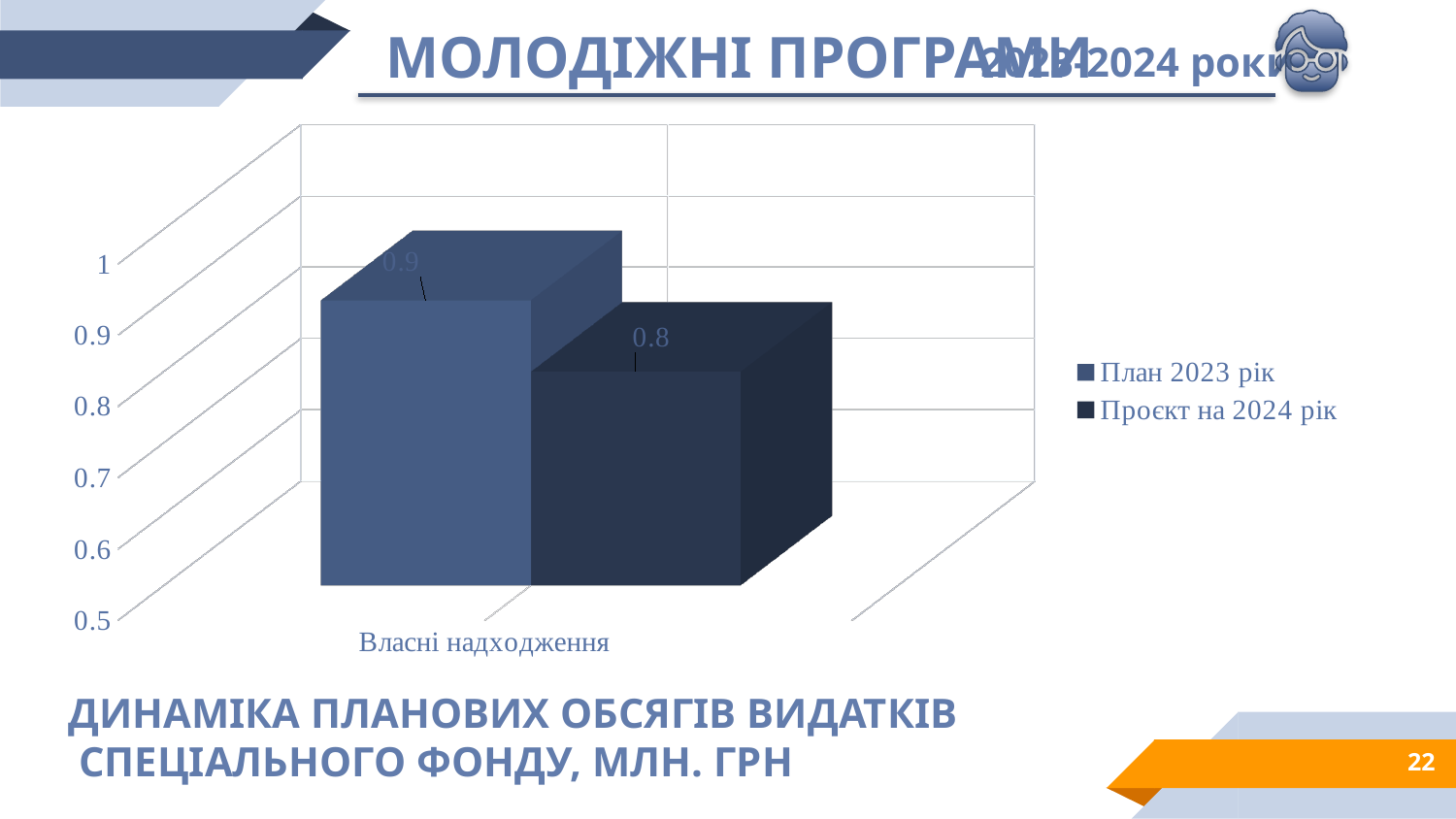
What is the difference between the План 2023 рік value and the Проєкт на 2024 рік value for Власні надходження? 0.1 What is the name of the category shown on the x axis? Власні надходження What kind of chart is shown on the slide? Bar chart Which series has the lowest value in the chart? Проєкт на 2024 рік What is the value for Проєкт на 2024 рік for Власні надходження? 0.8 What is the value for План 2023 рік for Власні надходження? 0.9 Which series has the higher value for Власні надходження, План 2023 рік or Проєкт на 2024 рік? План 2023 рік Is the value for План 2023 рік greater or less than 0.7? greater How many series does the legend list? 2 Is the value for Проєкт на 2024 рік greater or less than 0.9? less How many categories are shown on the x axis? 1 What is the lowest value shown on the vertical axis? 0.5